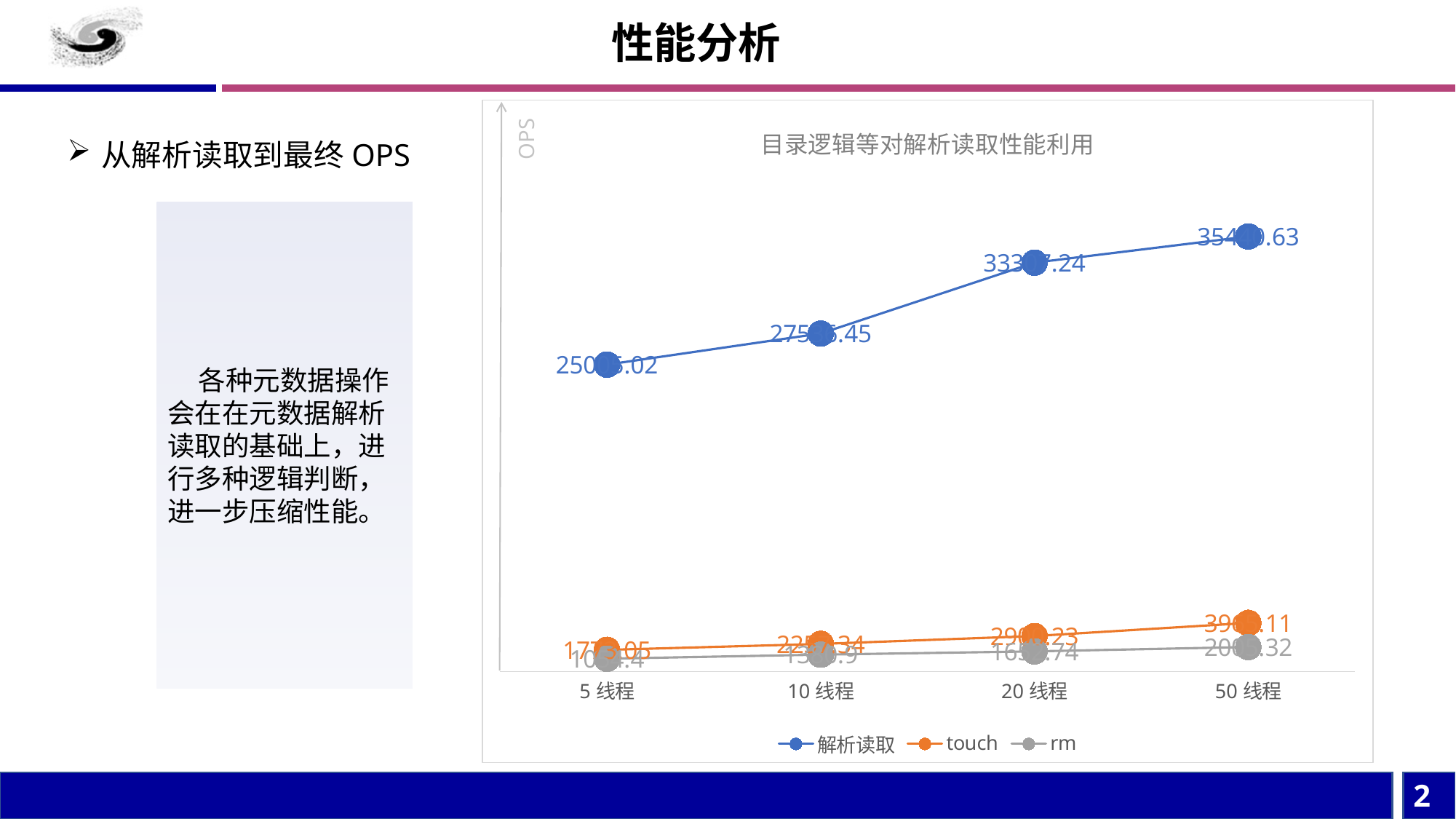
At 50 线程, which series has the larger value, touch or rm? touch At 20 线程, which series has the larger value, 解析读取 or touch? 解析读取 What label is shown on the vertical axis of the chart? OPS Which series has the lowest values across all thread counts? rm What is the title of the chart? 目录逻辑等对解析读取性能利用 How many series does the chart legend list? 3 What kind of chart is shown on the slide? line chart How many thread-count categories are plotted along the x axis? 4 For the 解析读取 series, at which thread count is the value lowest? 5 线程 Does the 解析读取 series rise or fall as the thread count increases from 5 线程 to 50 线程? rise For the 解析读取 series, at which thread count is the value highest? 50 线程 Which series has the highest values across all thread counts? 解析读取